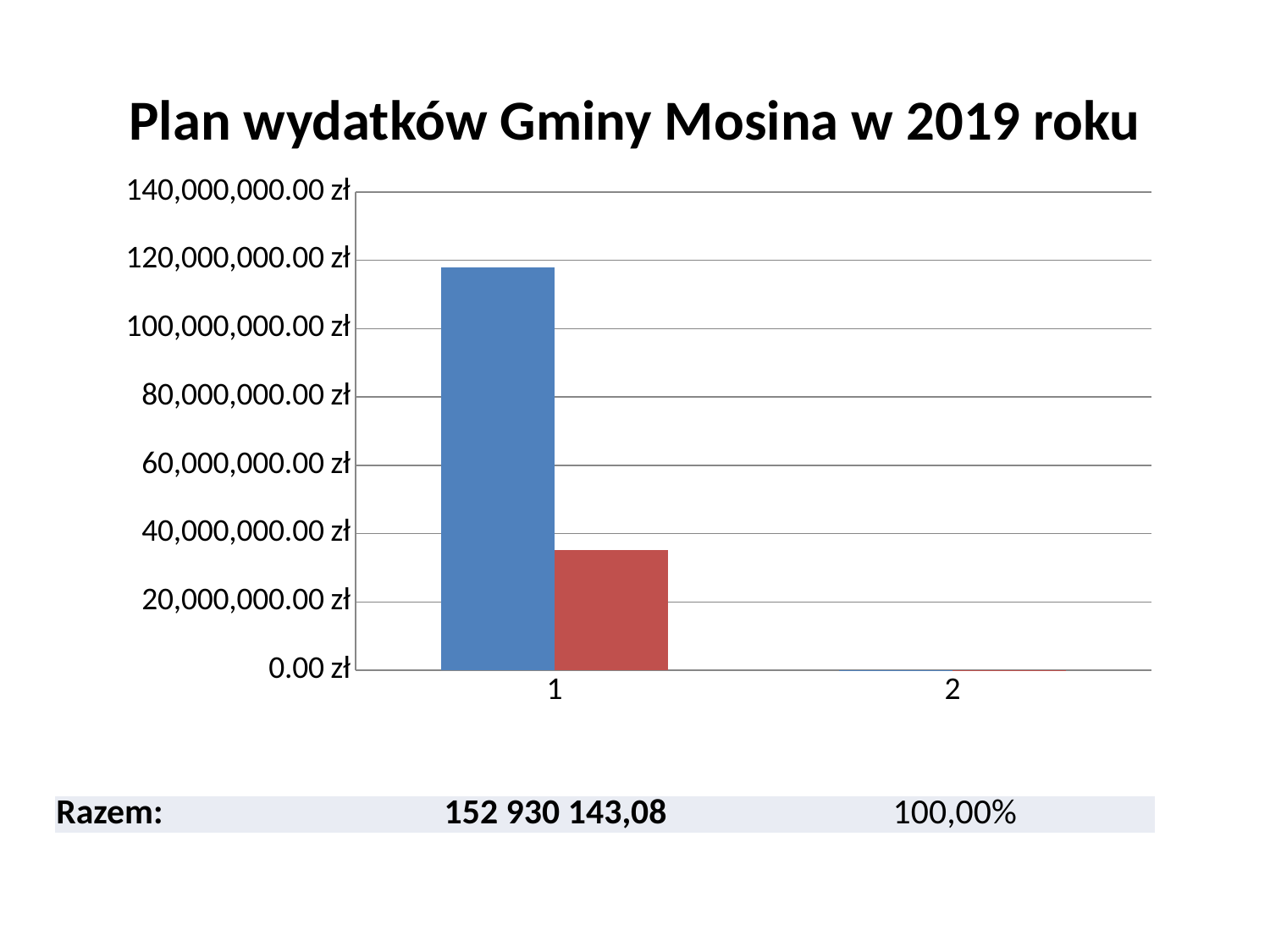
Are the bars for category 2 greater or less than 20,000,000.00 zł? less What is the title of the chart? Plan wydatków Gminy Mosina w 2019 roku Is the value of the blue bar for category 1 greater or less than 120,000,000.00 zł? less For category 1, which bar is larger, the blue one or the red one? the blue one Is the value of the red bar for category 1 greater or less than 40,000,000.00 zł? less How many bars are plotted for category 1? 2 How many categories are shown on the x axis of the chart? 2 Do the values rise or fall from category 1 to category 2? fall What kind of chart is shown on the slide? bar chart Which category has the tallest bar in the chart? 1